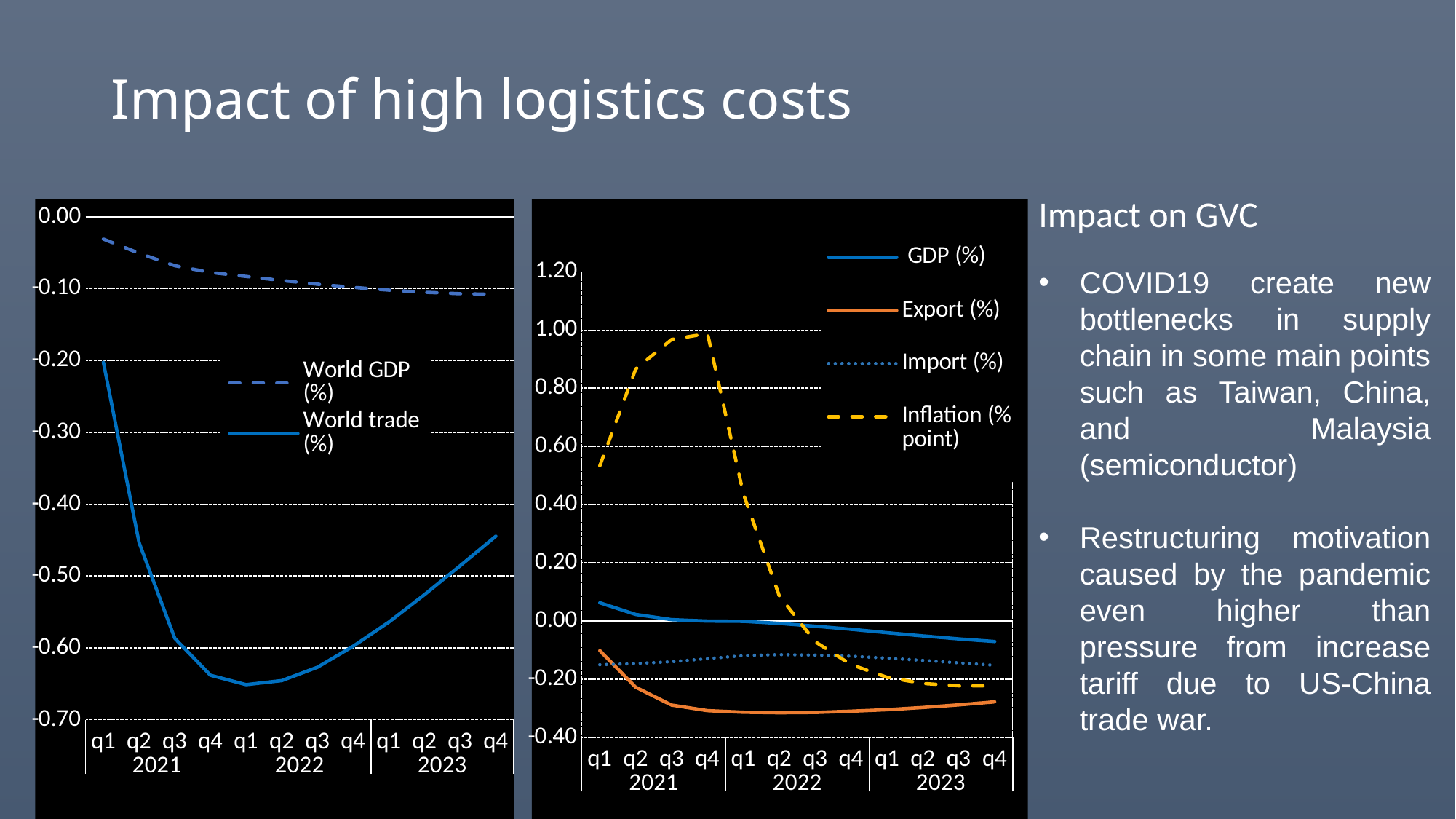
How many quarterly points are plotted along the x axis of the left chart? 12 How many series does the legend of the right chart list? 4 What kind of chart is the left chart? line chart In the right chart, is the value of Inflation (% point) in q1 2021 greater or less than 0.40? greater In the left chart, is the value of World trade (%) in q4 2021 greater or less than -0.60? less In the left chart, does the World GDP (%) line rise or fall from q1 2021 to q4 2023? fall In the right chart, which series has the lowest value in q1 2023? Export (%) In the right chart, which series has the highest value in q4 2021? Inflation (% point) In the right chart, is the value of Export (%) in q2 2022 greater or less than -0.20? less In the right chart, which series is drawn with a yellow dashed line? Inflation (% point) In the left chart, which series is lower throughout the period, World GDP (%) or World trade (%)? World trade (%)